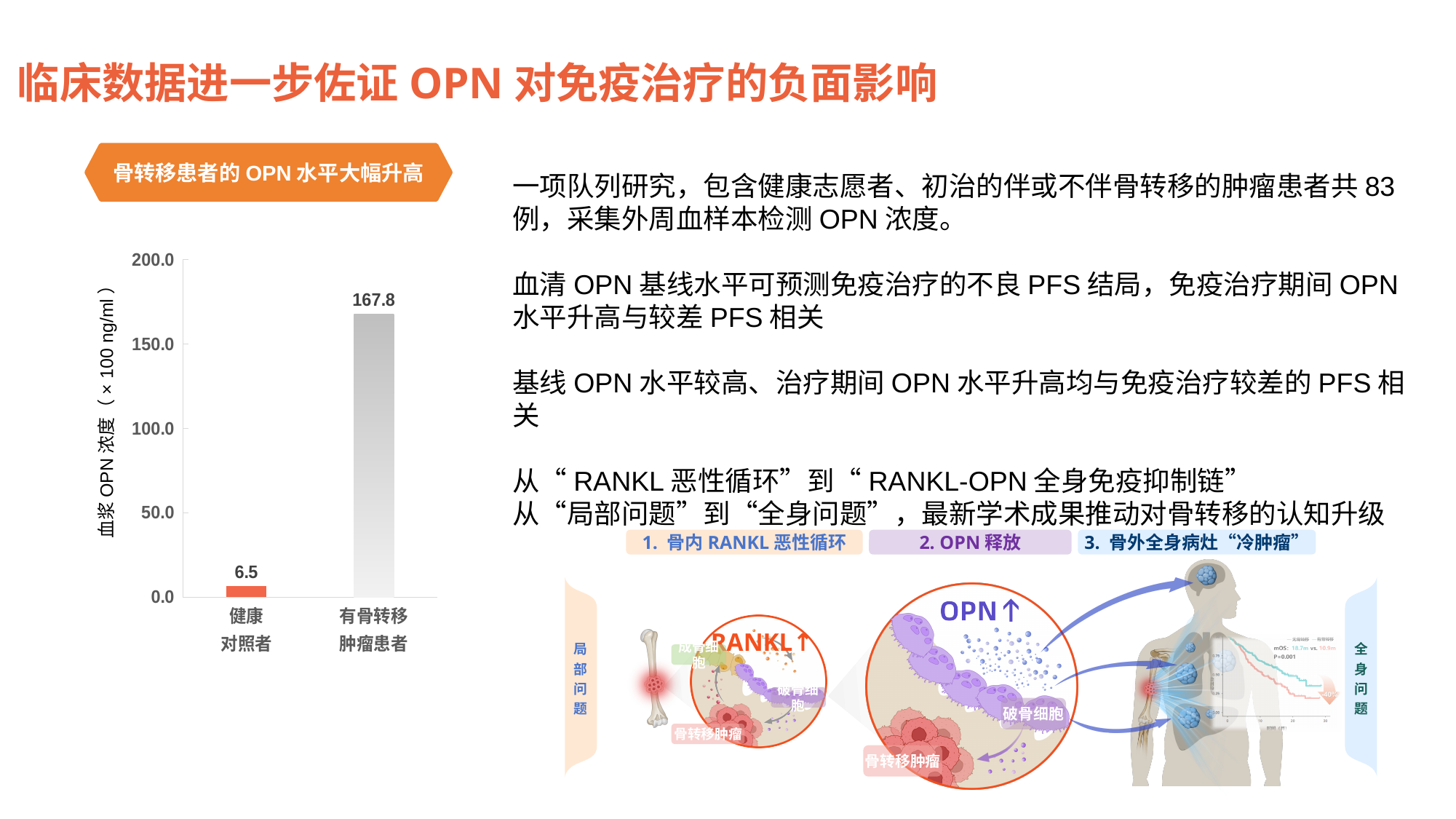
What type of chart is used to show the plasma OPN concentrations? Bar chart What is the label of the y-axis of the bar chart? 血浆 OPN 浓度（× 100 ng/ml） Is the OPN value for 有骨转移肿瘤患者 greater or less than 150.0? greater What is the difference between the OPN values for 有骨转移肿瘤患者 and 健康对照者? 161.3 What is the title shown above the bar chart? 骨转移患者的 OPN 水平大幅升高 What is the plasma OPN concentration value shown for the 有骨转移肿瘤患者 (tumor patients with bone metastasis) bar? 167.8 Is the OPN value for 健康对照者 greater or less than 50.0? less What is the maximum value shown on the y-axis of the bar chart? 200.0 Which category has the higher plasma OPN concentration in the bar chart? 有骨转移肿瘤患者 How many categories are plotted in the bar chart? 2 Which category has the lowest plasma OPN concentration in the bar chart? 健康对照者 What is the plasma OPN concentration value shown for the 健康对照者 (healthy controls) bar? 6.5